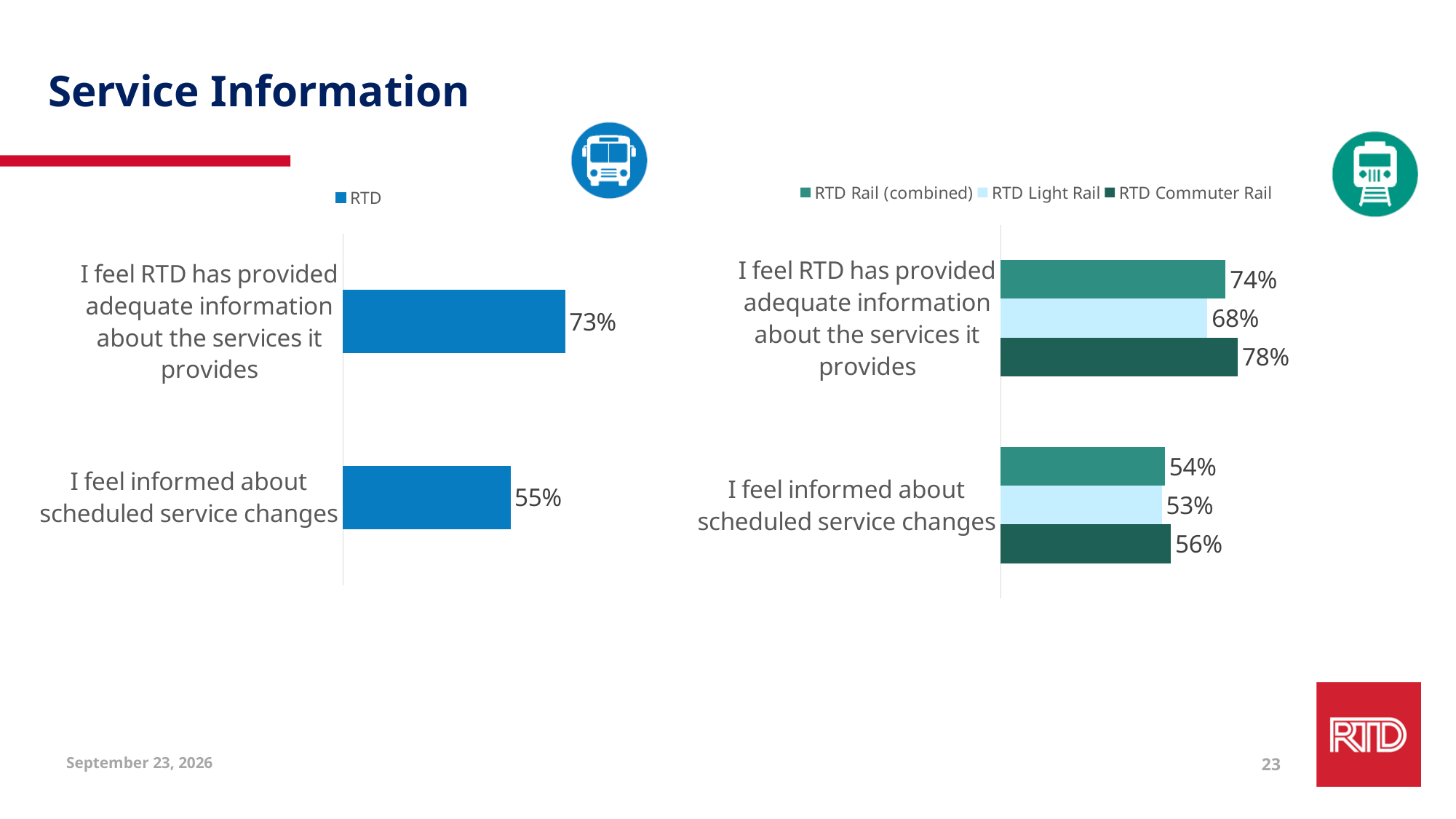
In the left chart (RTD bus), what is the value for "I feel RTD has provided adequate information about the services it provides"? 73% In the left chart (RTD bus), what is the value for "I feel informed about scheduled service changes"? 55% In the right chart (rail), what is the RTD Rail (combined) value for "I feel RTD has provided adequate information about the services it provides"? 74% In the right chart (rail), what is the RTD Commuter Rail value for "I feel RTD has provided adequate information about the services it provides"? 78% In the right chart (rail), which series has the highest value for "I feel RTD has provided adequate information about the services it provides"? RTD Commuter Rail In the left chart (RTD bus), what is the difference between the two bars? 18% In the right chart (rail), what is the difference between the RTD Commuter Rail and RTD Light Rail values for "I feel RTD has provided adequate information about the services it provides"? 10% In the right chart (rail), which series has the lowest value for "I feel informed about scheduled service changes"? RTD Light Rail Which is larger: the RTD bus value for "I feel informed about scheduled service changes" in the left chart, or the RTD Rail (combined) value for the same statement in the right chart? RTD bus (55%) What kind of chart is the left chart (RTD bus)? Bar chart In the right chart (rail), what is the RTD Light Rail value for "I feel informed about scheduled service changes"? 53% How many series does the legend of the right chart (rail) list? 3